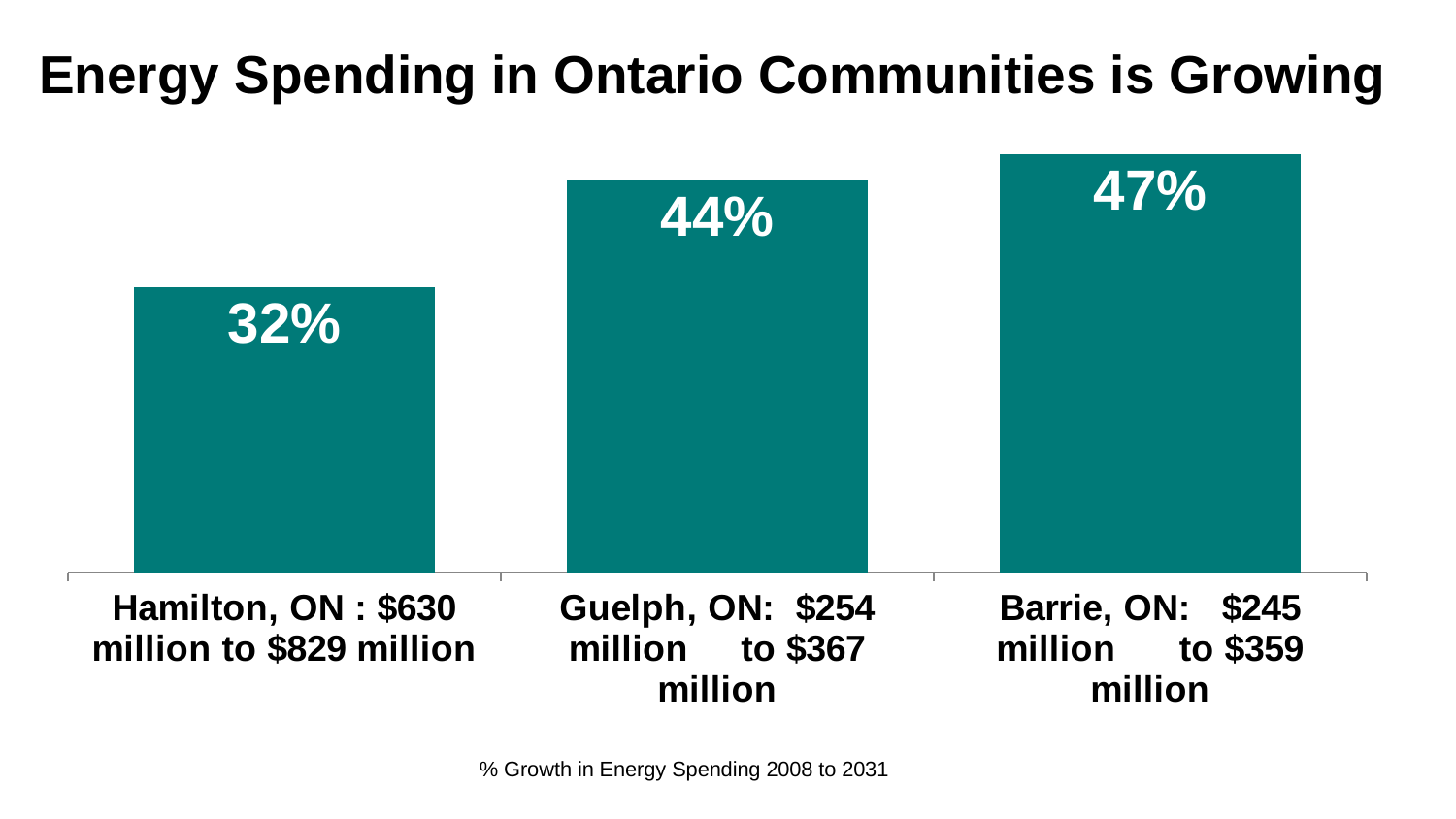
What kind of chart is shown on the slide? Bar chart What is the % growth in energy spending shown for Guelph, ON? 44% What is the % growth in energy spending shown for Barrie, ON? 47% What is the difference in percentage points between the growth for Guelph, ON and Hamilton, ON? 12 percentage points Which community has the highest % growth in energy spending? Barrie, ON Which has a higher % growth in energy spending, Guelph, ON or Hamilton, ON? Guelph, ON What is the % growth in energy spending shown for Hamilton, ON? 32% How many communities are shown in the chart? 3 Do the values rise or fall from left to right across the chart? Rise What period does the % growth in energy spending cover, according to the chart's caption? 2008 to 2031 Which community has the lowest % growth in energy spending? Hamilton, ON What is the difference in percentage points between the growth for Barrie, ON and Hamilton, ON? 15 percentage points